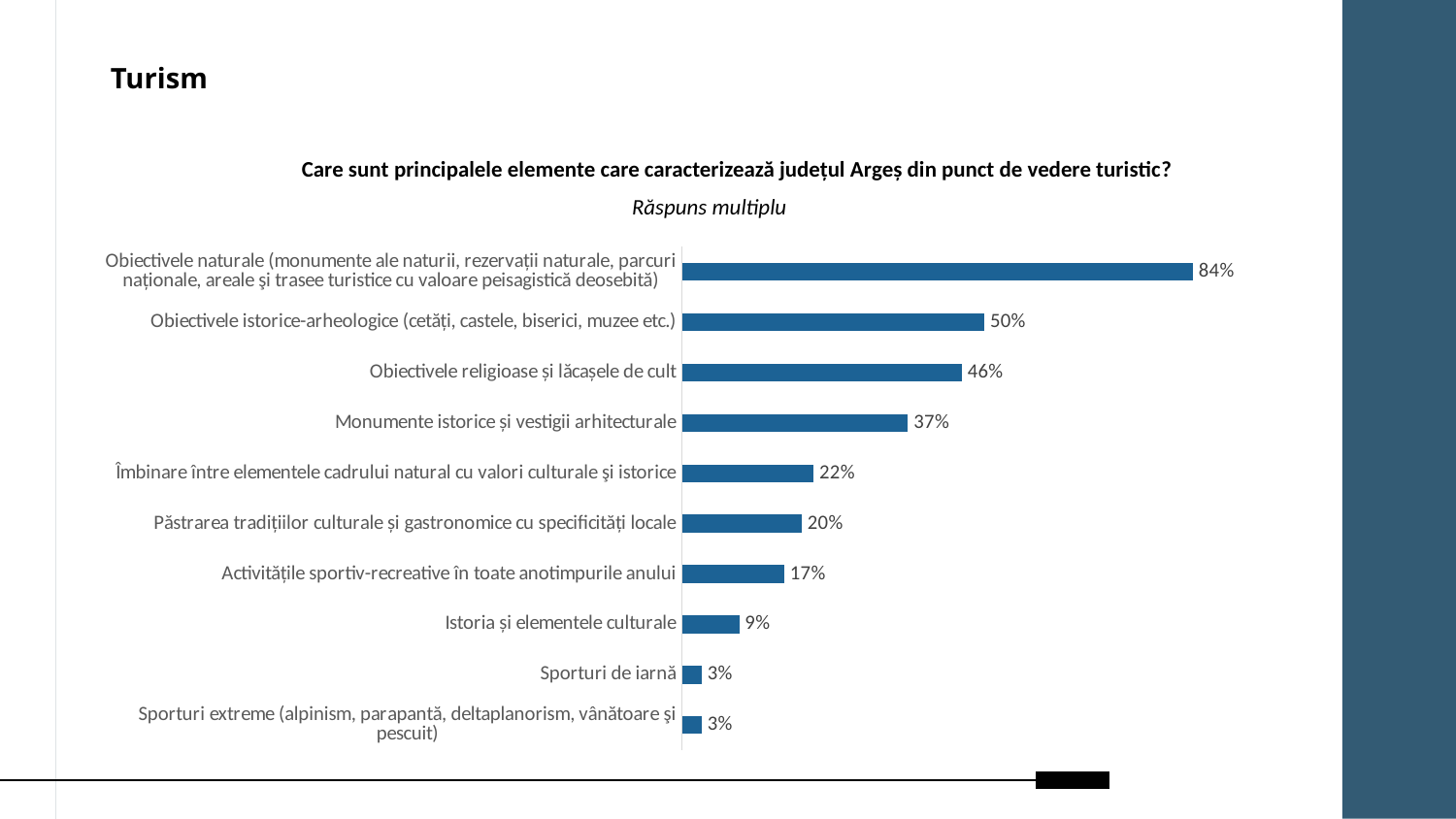
What type of chart is shown on the slide? Bar chart What question is the chart answering, according to its title? Care sunt principalele elemente care caracterizează județul Argeș din punct de vedere turistic? What is the lowest value shown in the chart? 3% What percentage is shown for "Istoria și elementele culturale"? 9% Which is larger: the value for "Păstrarea tradițiilor culturale și gastronomice cu specificități locale" or for "Activitățile sportiv-recreative în toate anotimpurile anului"? Păstrarea tradițiilor culturale și gastronomice cu specificități locale What is the value of the highest bar? 84% What is the value for "Monumente istorice și vestigii arhitecturale"? 37% How many categories are shown in the chart? 10 What percentage is shown for "Obiectivele istorice-arheologice (cetăți, castele, biserici, muzee etc.)"? 50% What is the difference between the highest and the lowest values in the chart? 81% Which category has the highest value? Obiectivele naturale (monumente ale naturii, rezervații naturale, parcuri naționale, areale și trasee turistice cu valoare peisagistică deosebită) What is the difference between the values for "Obiectivele religioase și lăcașele de cult" and "Îmbinare între elementele cadrului natural cu valori culturale și istorice"? 24%